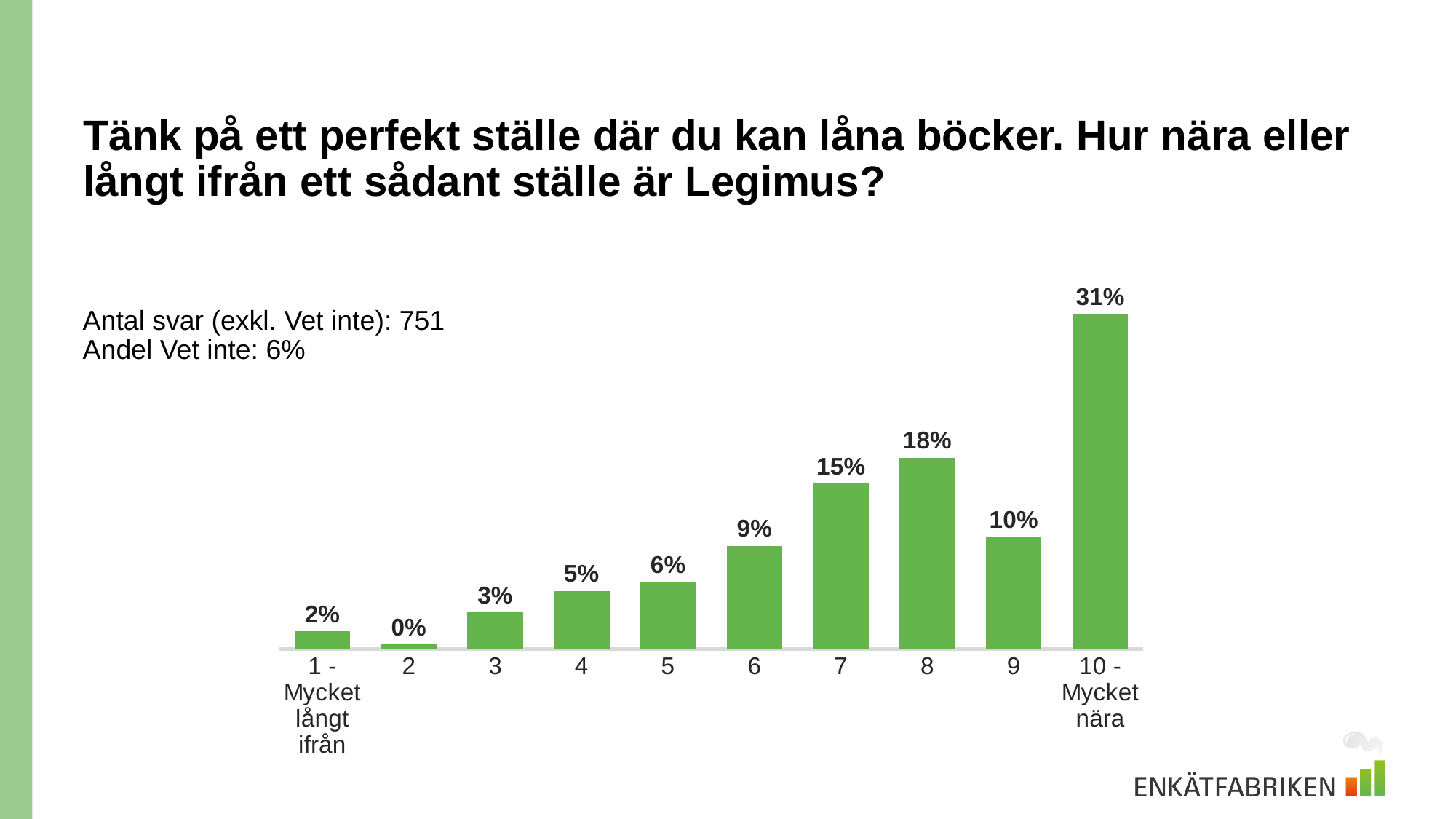
Which is larger, the value for category 6 or the value for category 9? 9 Which category has the lowest value? 2 What is the number of responses (Antal svar, exkl. Vet inte) stated on the slide? 751 What is the value for category "10 - Mycket nära"? 31% What kind of chart is shown on the slide? Bar chart What is the difference between the values for category 10 - Mycket nära and category 7? 16% What is the value for category 7? 15% How many categories are shown on the x axis? 10 What is the value for category "1 - Mycket långt ifrån"? 2% What is the value for category 9? 10% What is the difference between the values for category 8 and category 9? 8% Which category has the highest value? 10 - Mycket nära